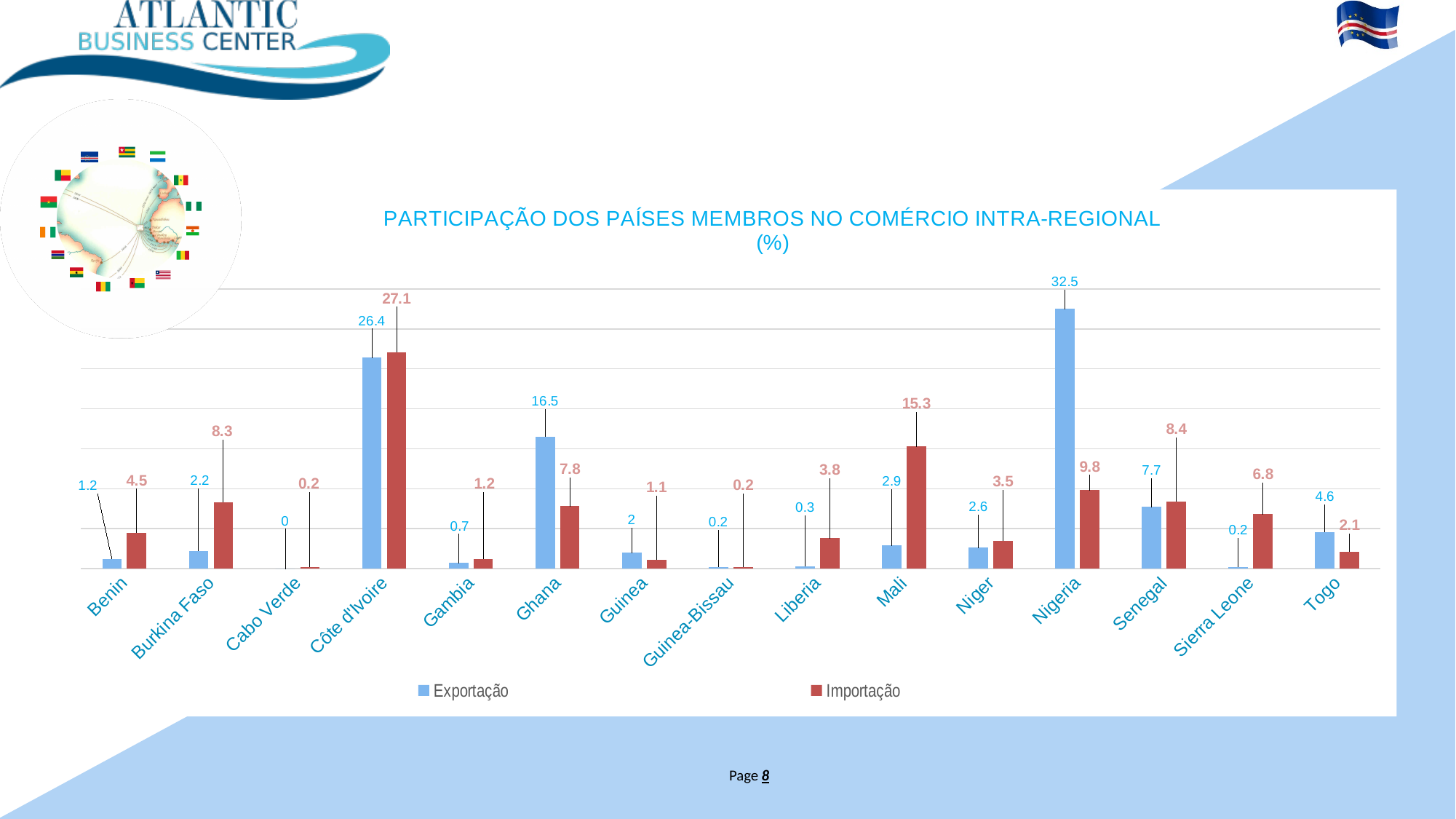
How many series does the legend list? 2 What is the Importação value for Mali? 15.3 Which is larger for Ghana, Exportação or Importação? Exportação Which country has the lowest Exportação value? Cabo Verde What is the difference between the Importação and Exportação values for Mali? 12.4 Which country has the highest Exportação value? Nigeria What is the Exportação value for Nigeria? 32.5 What is the Exportação value for Côte d'Ivoire? 26.4 What is the difference between the Exportação values for Nigeria and Côte d'Ivoire? 6.1 How many countries are shown on the x axis? 15 Which country has the highest Importação value? Côte d'Ivoire What kind of chart is shown on the slide? Bar chart